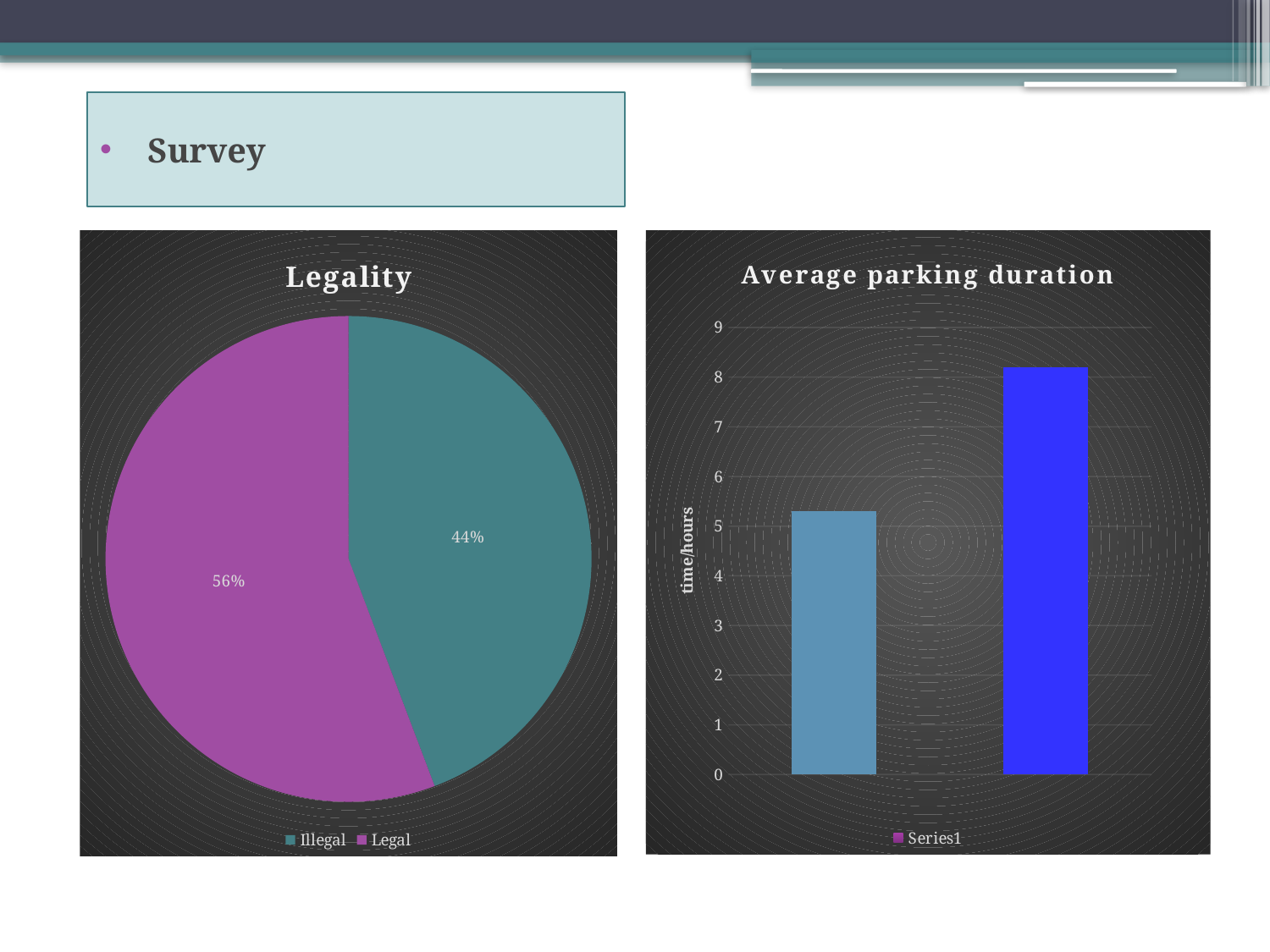
What kind of chart is the Legality chart? pie chart In the Average parking duration chart, is the value of the right bar greater or less than 7? greater How many bars are in the Average parking duration chart? 2 In the Legality chart, what share of the pie is Legal? 56% What is the y-axis label of the Average parking duration chart? time/hours In the Legality chart, which slice is the smallest? Illegal In the Average parking duration chart, is the value of the left bar greater or less than 6? less In the Legality chart, what share of the pie is Illegal? 44% What kind of chart is the Average parking duration chart? bar chart How many slices does the Legality pie chart have? 2 In the Legality chart, what is the difference in percentage points between the Legal and Illegal slices? 12 In the Legality chart, which slice is larger, Illegal or Legal? Legal